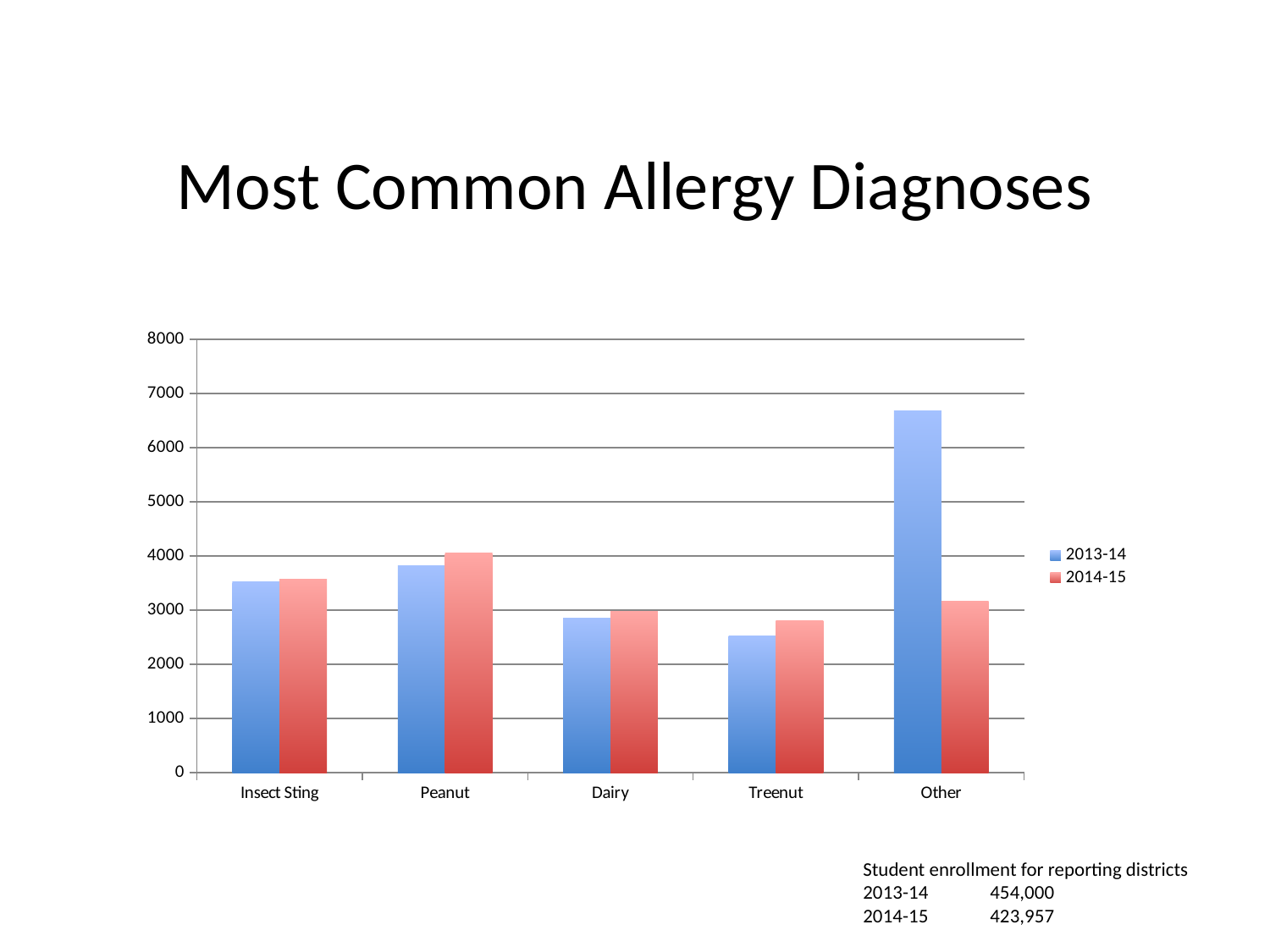
For the Other category, which year has the larger value, 2013-14 or 2014-15? 2013-14 How many allergy categories are shown on the x axis? 5 What are the two entries listed in the legend? 2013-14 and 2014-15 Which category has the lowest value for 2014-15? Treenut Is the 2013-14 value for Other greater or less than 6000? greater What kind of chart is shown on the slide? bar chart Which category has the highest value for 2014-15? Peanut Is the 2013-14 value for Treenut greater or less than 3000? less Which is larger for 2013-14, Peanut or Dairy? Peanut Which category has the highest value for 2013-14? Other Which category has the lowest value for 2013-14? Treenut How many series does the legend list? 2